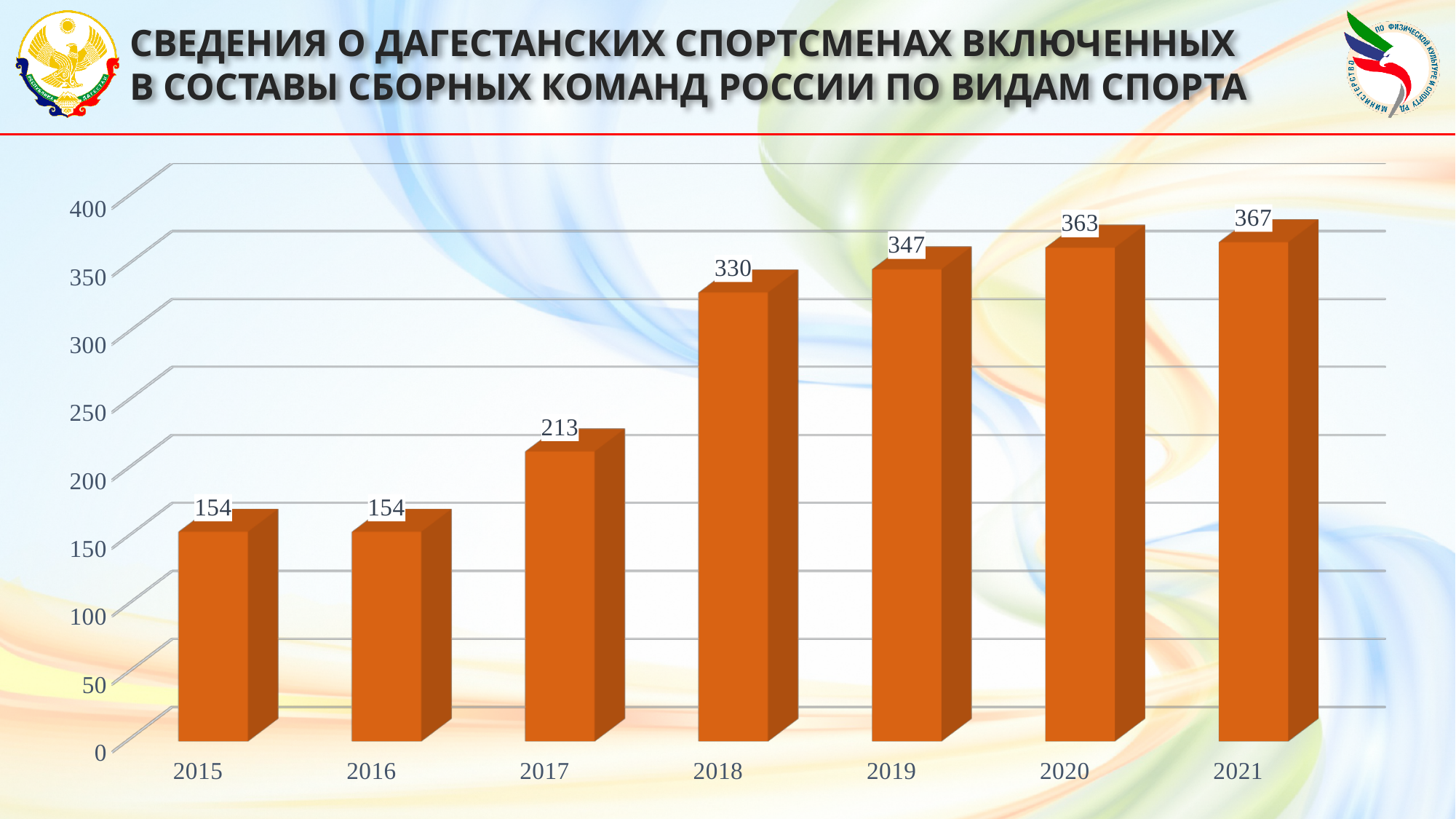
Which is larger, the value for 2017 or the value for 2018? 2018 How many years are shown on the x axis? 7 What is the value for 2017? 213 What is the difference between the values for 2021 and 2015? 213 What is the value for 2018? 330 What is the lowest value shown on the chart? 154 What is the value for 2020? 363 Is the value for 2019 greater or less than 300? greater What is the difference between the values for 2019 and 2018? 17 What kind of chart is shown on the slide? bar chart Do the values generally rise or fall from 2015 to 2021? rise Which year has the highest value? 2021